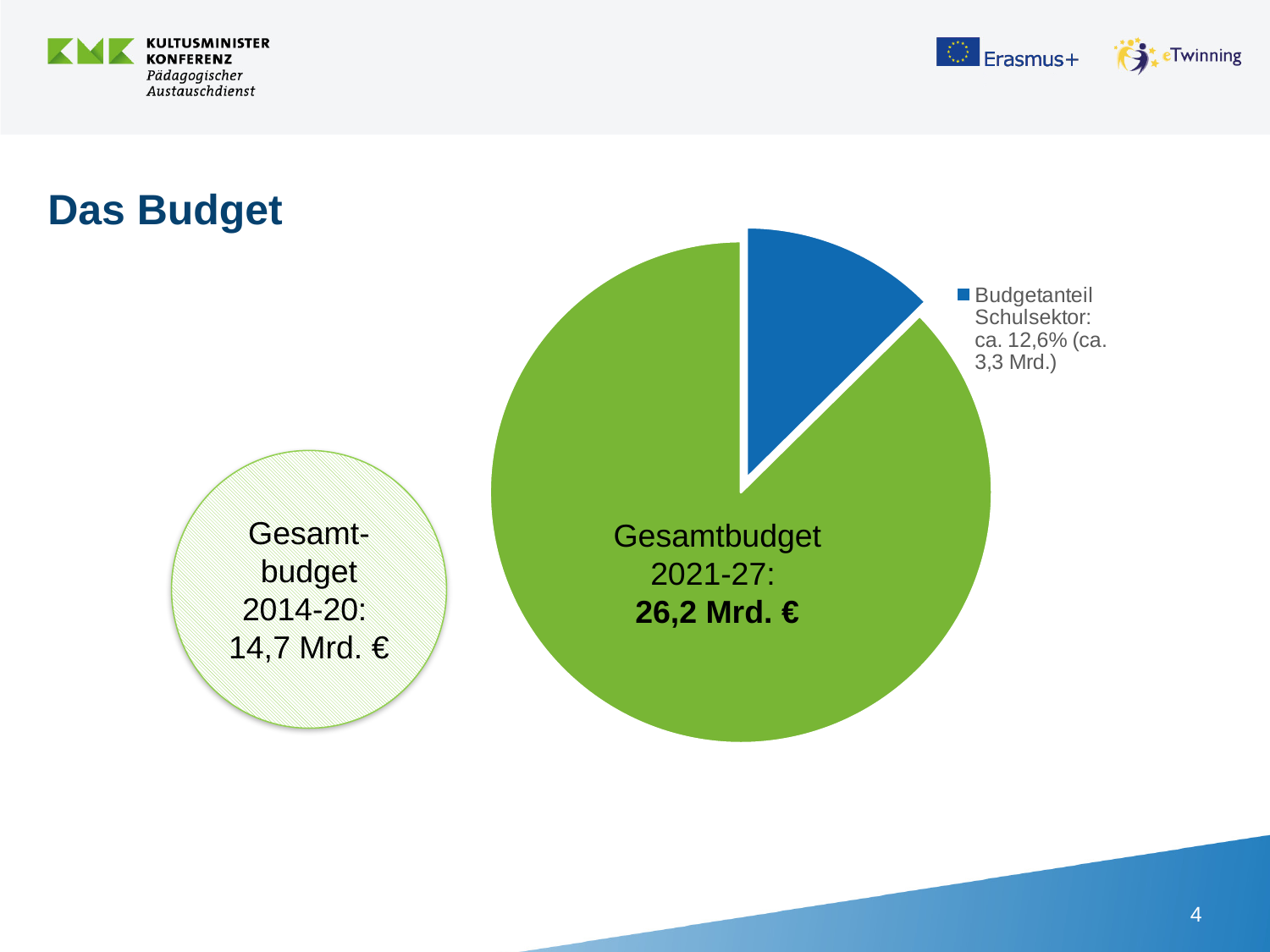
What share of the budget does the legend give for the Budgetanteil Schulsektor slice? ca. 12,6% Which slice of the pie chart is the smallest? Budgetanteil Schulsektor Is the share of the Budgetanteil Schulsektor slice greater or less than 50%? less What is the title of the slide containing the pie chart? Das Budget What was the Gesamtbudget for 2014-20 shown in the circle to the left of the pie chart? 14,7 Mrd. € By how much is the Gesamtbudget 2021-27 larger than the Gesamtbudget 2014-20? 11,5 Mrd. € What amount does the legend give for the Budgetanteil Schulsektor slice? ca. 3,3 Mrd. What kind of chart is shown on the slide? pie chart Which slice of the pie chart is larger, the green Gesamtbudget 2021-27 slice or the blue Budgetanteil Schulsektor slice? Gesamtbudget 2021-27 What colour is the Budgetanteil Schulsektor slice in the pie chart? blue How many slices does the pie chart have? 2 What is the total budget for 2021-27 shown in the pie chart? 26,2 Mrd. €